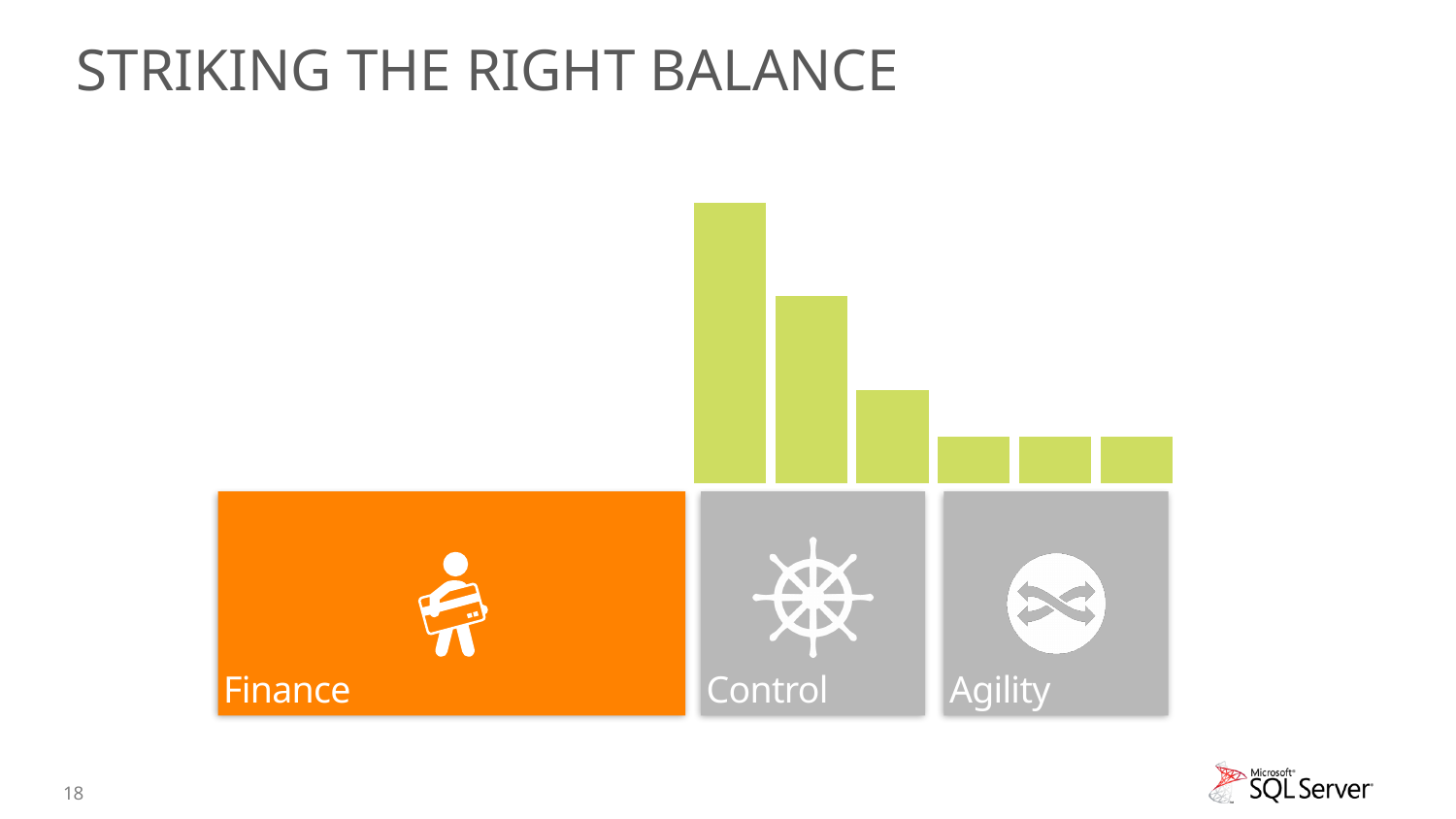
Which bar in the chart is the tallest? the leftmost bar Is the third bar from the left taller or shorter than the second bar from the left? shorter Which two labelled boxes sit directly beneath the bars of the chart? Control and Agility Is the leftmost bar taller or shorter than the second bar from the left? taller Do the bar heights rise or fall from left to right across the chart? fall What colour are the bars in the chart? green How many of the bars in the chart appear to be the same, shortest height? 3 What kind of chart is shown on the slide? bar chart How many bars does the chart on the slide contain? 6